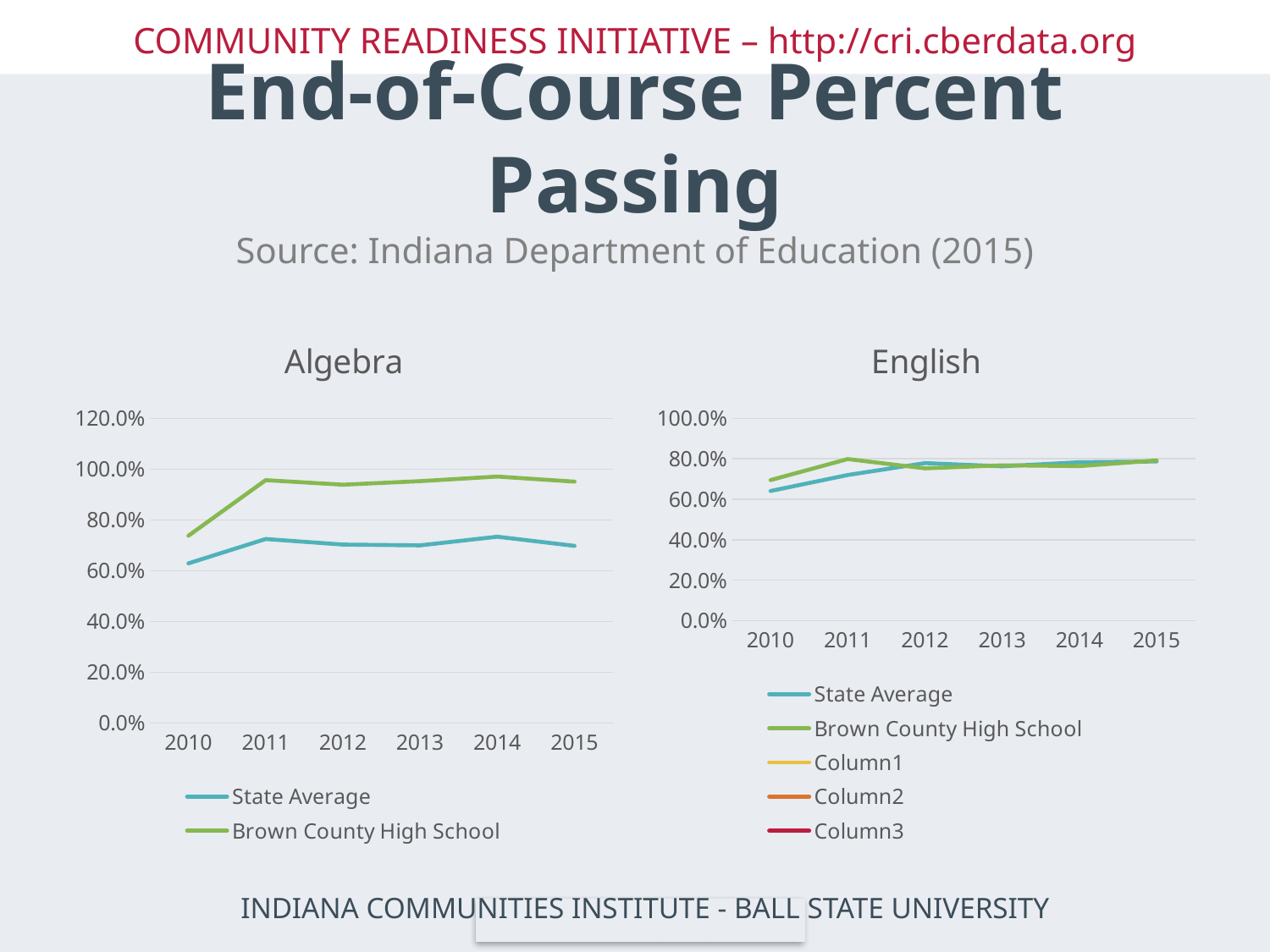
What are the titles of the two charts on the slide? Algebra and English In the Algebra chart, in which year is the State Average at its lowest? 2010 How many entries does the legend of the English chart list? 5 In the English chart, does the State Average line rise or fall from 2010 to 2015? rise In the Algebra chart, is the State Average value for 2010 greater or less than 80.0%? less In the English chart, is the State Average value for 2010 greater or less than 80.0%? less How many years are shown on the x axis of the English chart? 6 How many series does the legend of the Algebra chart list? 2 In the Algebra chart, is the Brown County High School value for 2011 greater or less than 80.0%? greater In the Algebra chart, does the Brown County High School line rise or fall from 2010 to 2011? rise What kind of chart is the Algebra chart? line chart In the Algebra chart, which is larger in 2013: State Average or Brown County High School? Brown County High School